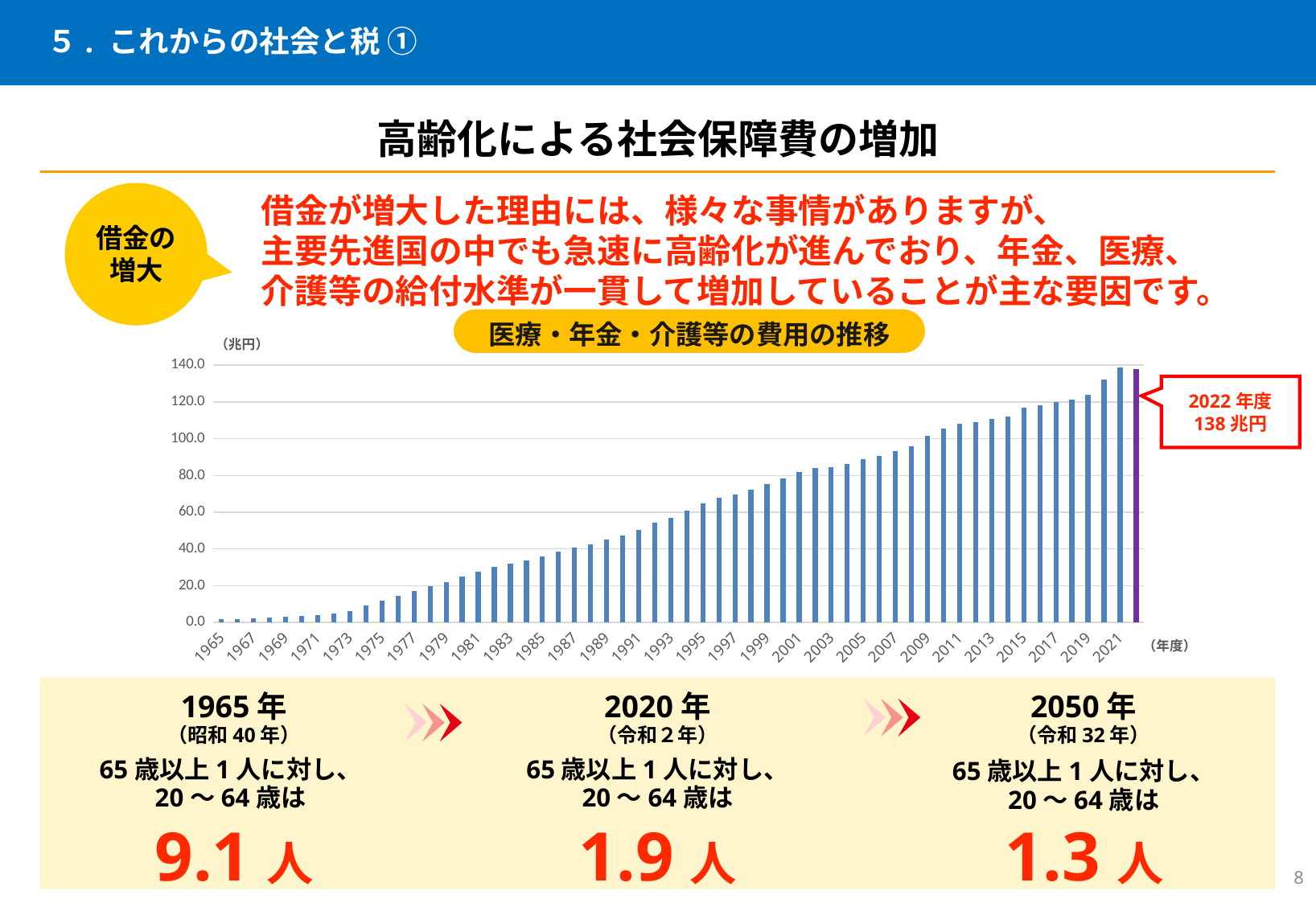
Is the value for 2013 greater or less than 100? greater Is the value for 1975 greater or less than 20? less What kind of chart is shown on the slide? bar chart Which is larger, the value for 1985 or the value for 2005? 2005 Which year has the lowest value in the chart? 1965 Is the value for 2021 greater or less than 120? greater What is the title of the chart? 医療・年金・介護等の費用の推移 What unit is shown on the vertical axis of the chart? 兆円 What value does the chart give for 2022年度? 138兆円 Which year has the highest value in the chart? 2021 Do the values rise or fall from 1965 to 2022? rise